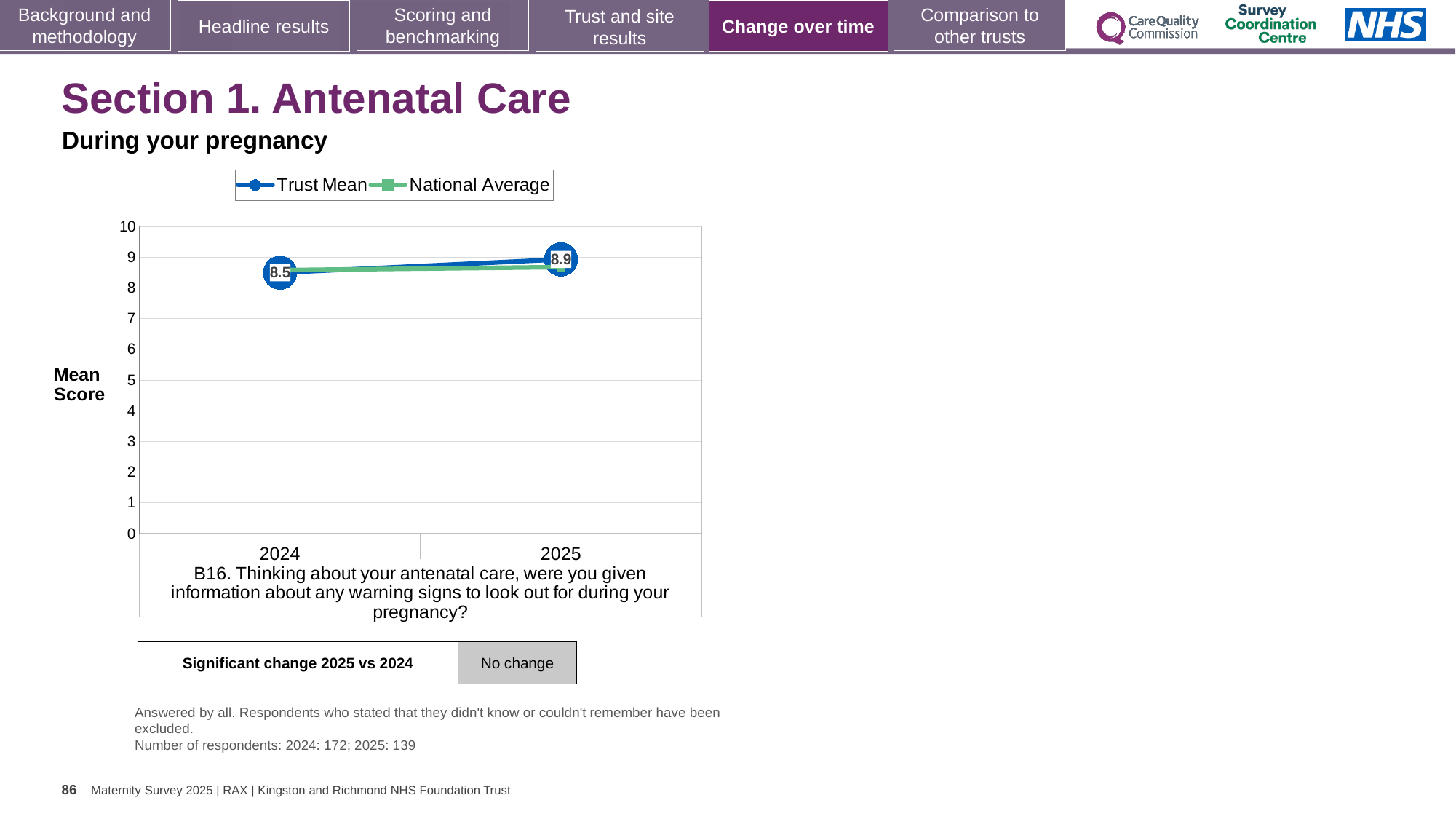
What is the Trust Mean score for 2025? 8.9 What is the label on the y axis of the chart? Mean Score How many series does the legend list? 2 In 2025, which is higher, the Trust Mean or the National Average? Trust Mean Is the National Average value for 2025 greater or less than 8? greater What is the Trust Mean score for 2024? 8.5 How many years are plotted on the x axis? 2 Does the Trust Mean rise or fall from 2024 to 2025? rise What kind of chart is shown on the slide? line chart By how much did the Trust Mean score change from 2024 to 2025? 0.4 What are the two series named in the legend? Trust Mean and National Average Which year has the higher Trust Mean score, 2024 or 2025? 2025